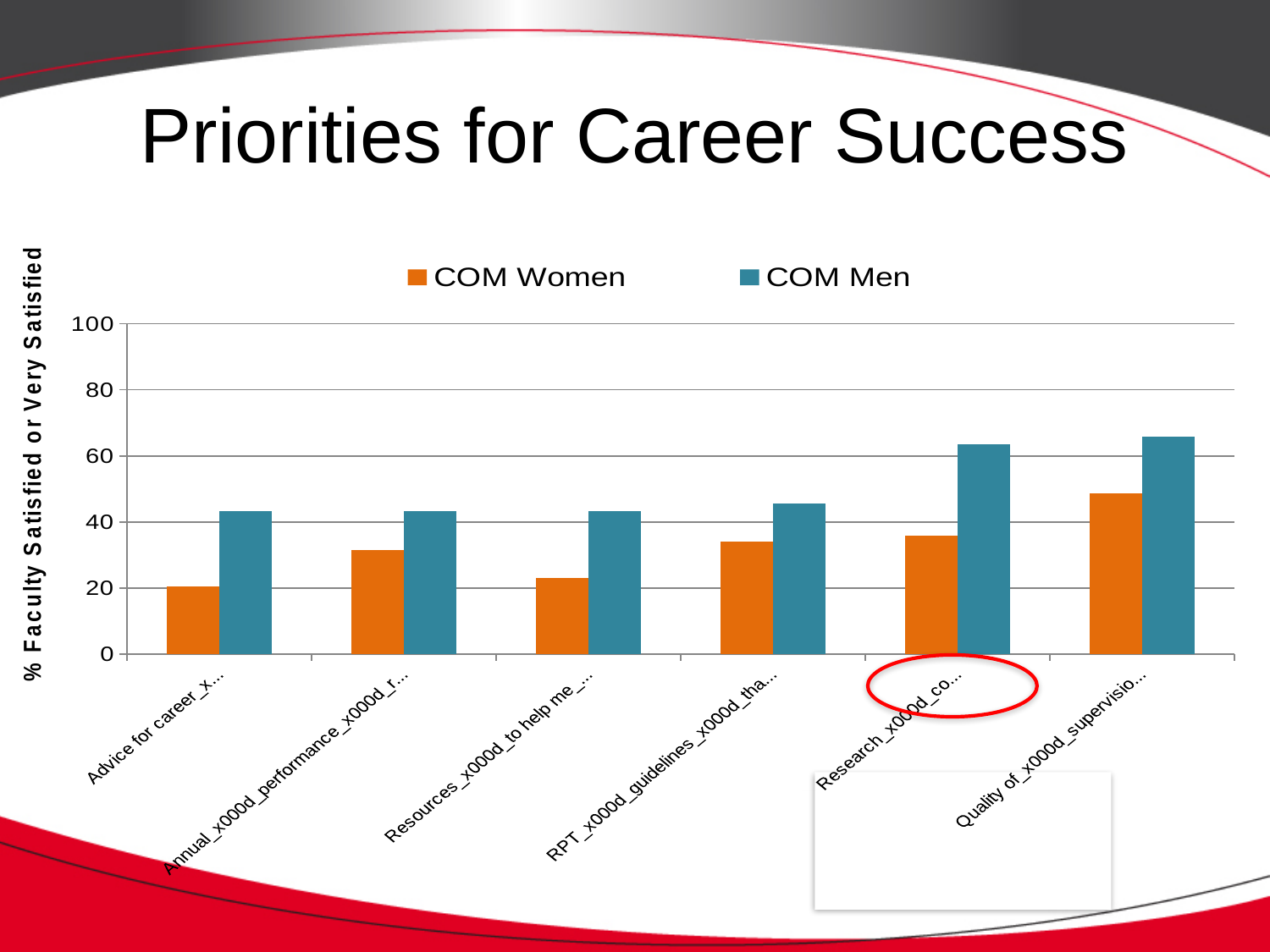
How many categories are plotted along the x axis? 6 Is the COM Men value for 'RPT guidelines' greater or less than 60? less Is the COM Women value for 'Advice for career' greater or less than 40? less What are the two series named in the legend? COM Women and COM Men Is the COM Women value for 'Quality of supervision' greater or less than 40? greater What is the title of the vertical axis? % Faculty Satisfied or Very Satisfied In the 'Advice for career' category, which series has the higher bar, COM Women or COM Men? COM Men For which category is the COM Women bar the highest? Quality of supervision (the last category) What kind of chart is shown on the slide? Bar chart How many series does the legend list? 2 For which category is the COM Women bar the lowest? Advice for career (the first category)